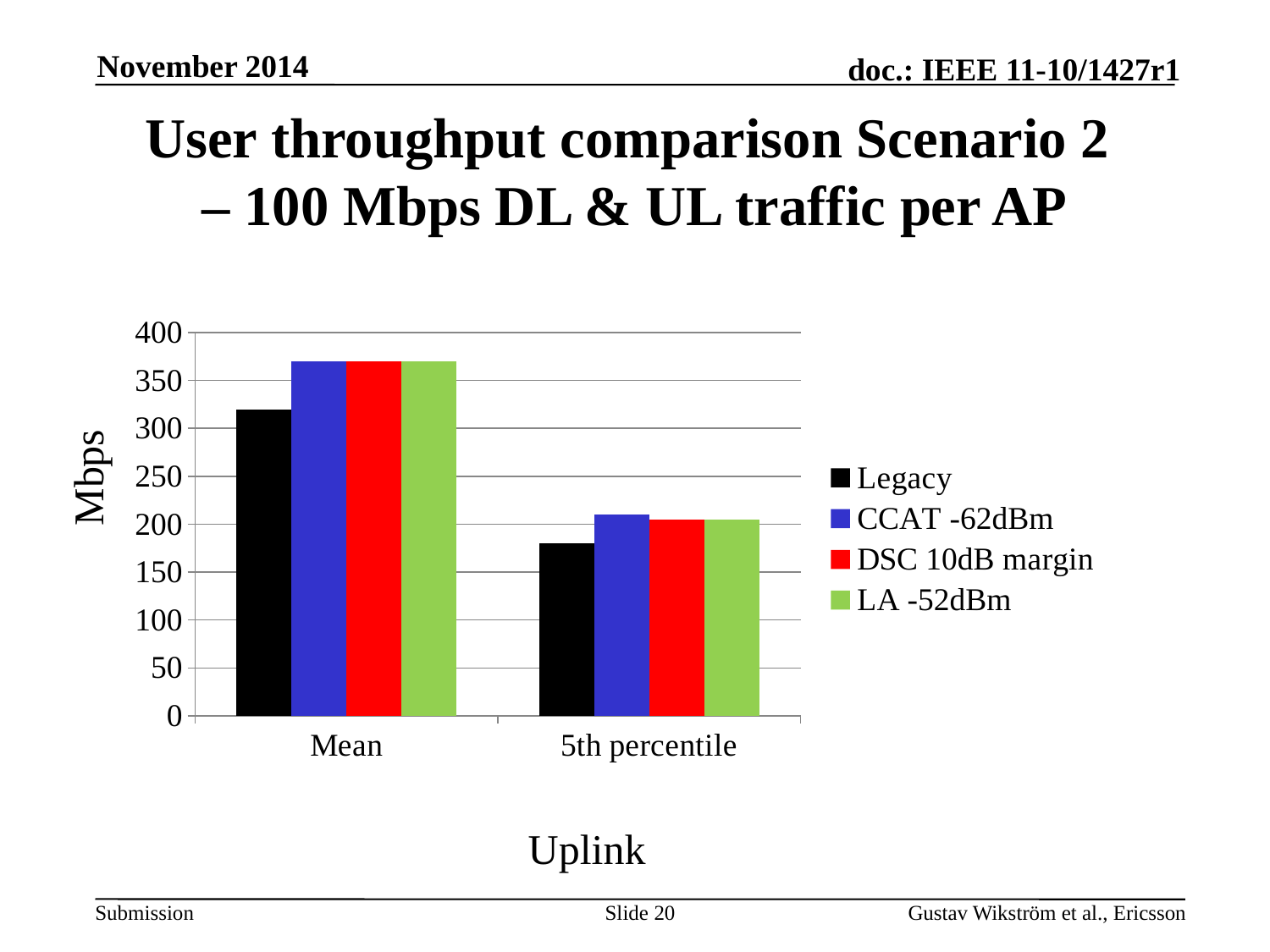
How many series does the legend list? 4 Is the value for Legacy in the 5th percentile category greater or less than 200? less Which series has the lowest value for the Mean category? Legacy Is the value for CCAT -62dBm in the Mean category greater or less than 350? greater Do the values for Legacy rise or fall from Mean to 5th percentile? fall Which series has the lowest value for the 5th percentile category? Legacy What is the label on the y axis of the chart? Mbps Is the value for Legacy in the Mean category greater or less than 300? greater Which is larger for the Mean category: Legacy or LA -52dBm? LA -52dBm What kind of chart is shown on the slide? bar chart How many categories are shown on the x axis? 2